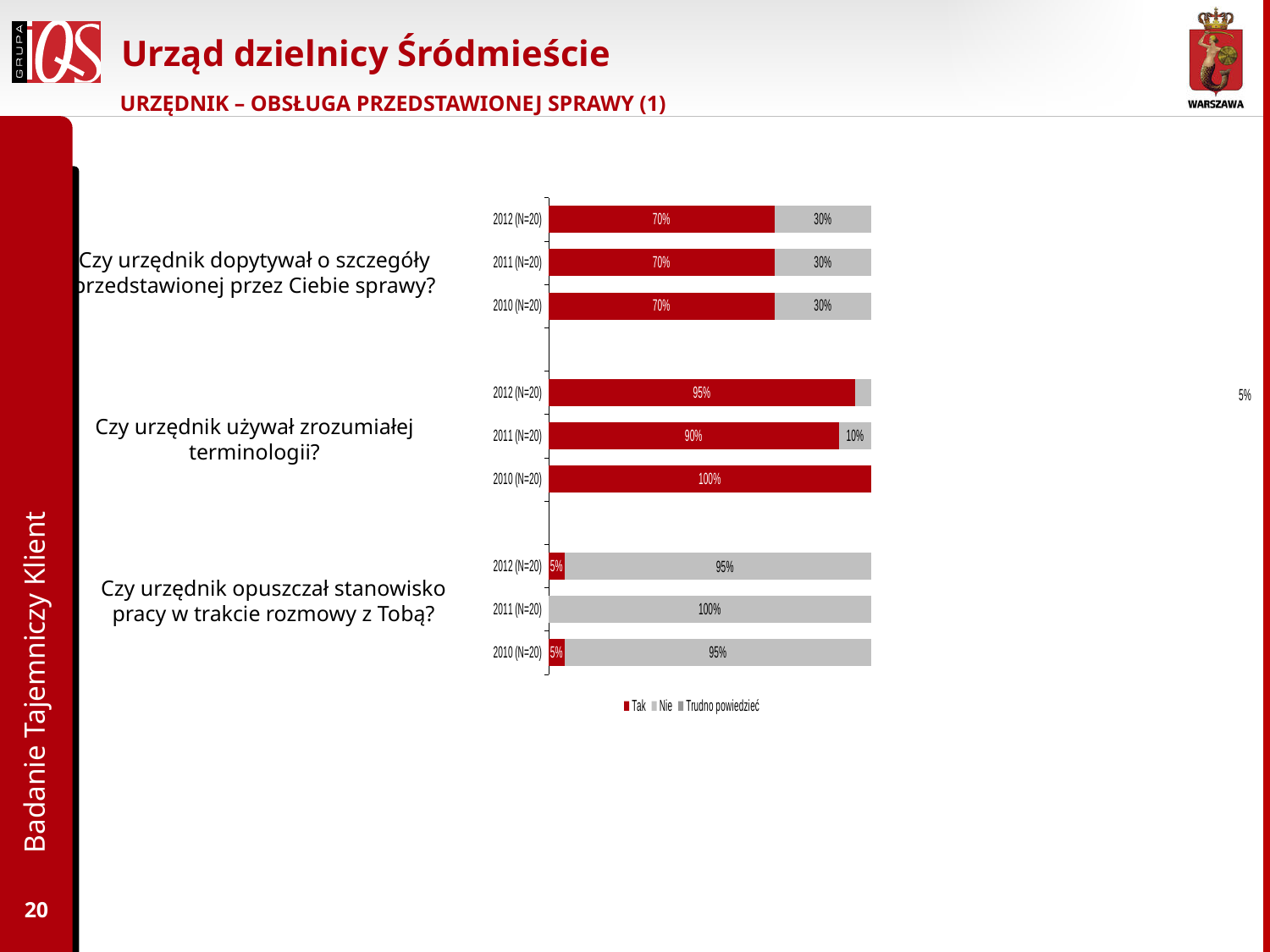
How many years (bars) are shown for the question "Czy urzędnik używał zrozumiałej terminologii?"? 3 For "Czy urzędnik używał zrozumiałej terminologii?", what is the Tak value for 2011 (N=20)? 90% For "Czy urzędnik dopytywał o szczegóły przedstawionej przez Ciebie sprawy?", what is the Nie value for 2011 (N=20)? 30% For "Czy urzędnik używał zrozumiałej terminologii?", what is the difference between the Tak value for 2012 (N=20) and the Tak value for 2011 (N=20)? 5 percentage points For "Czy urzędnik używał zrozumiałej terminologii?", what is the Nie value for 2011 (N=20)? 10% For "Czy urzędnik opuszczał stanowisko pracy w trakcie rozmowy z Tobą?", what is the Nie value for 2011 (N=20)? 100% How many series does the chart legend list? 3 What kind of chart is shown on the slide? bar chart For "Czy urzędnik używał zrozumiałej terminologii?", what is the Tak value for 2010 (N=20)? 100% What are the three series named in the chart legend? Tak, Nie, Trudno powiedzieć For "Czy urzędnik opuszczał stanowisko pracy w trakcie rozmowy z Tobą?", what is the Tak value for 2012 (N=20)? 5% For "Czy urzędnik dopytywał o szczegóły przedstawionej przez Ciebie sprawy?", what is the Tak value for 2012 (N=20)? 70%